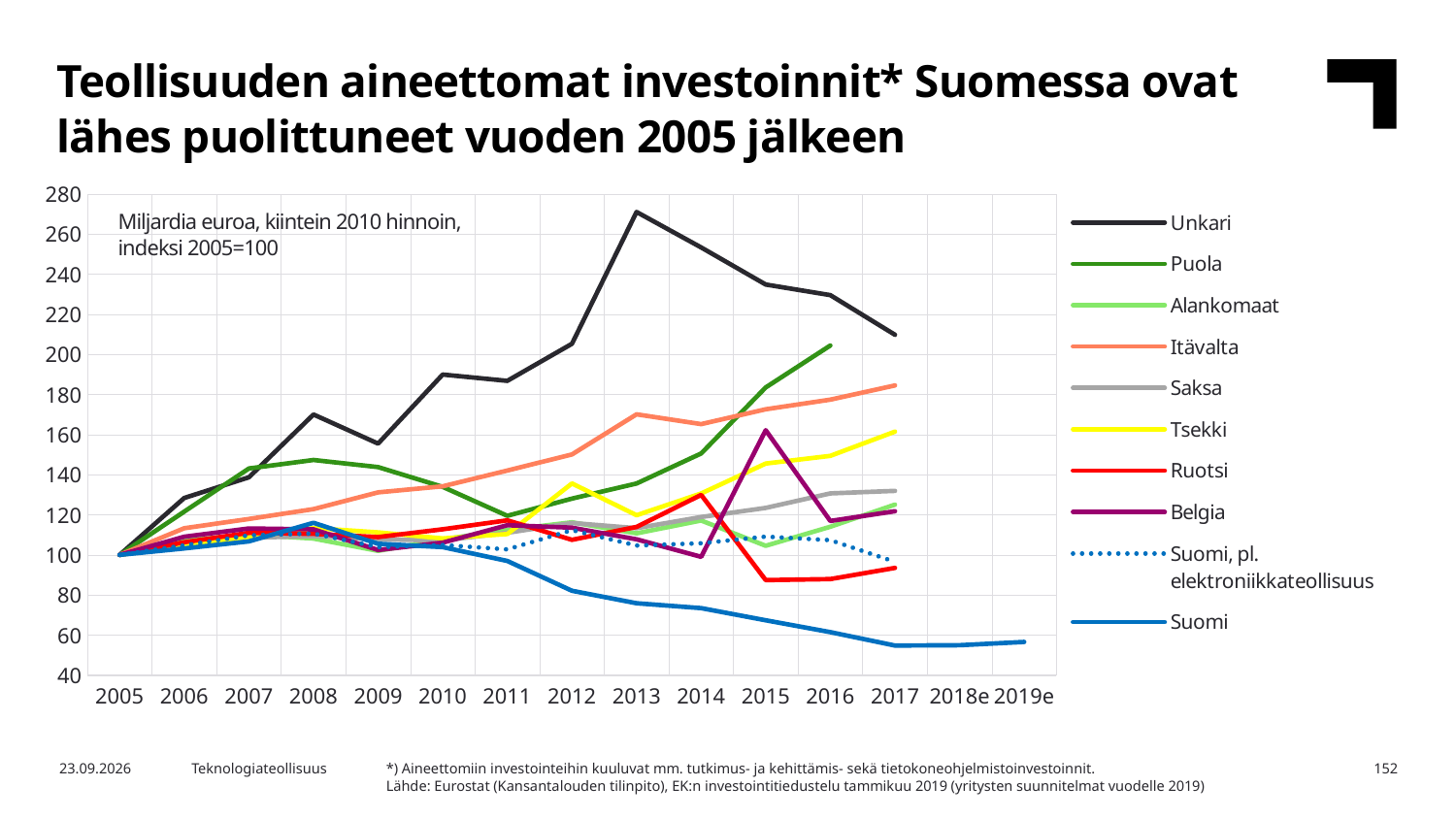
How many series does the legend list? 10 How many years are shown on the x axis? 15 Does the Suomi line rise or fall from 2008 to 2017? fall Which country has the highest value in 2013? Unkari Which series has the lowest value in 2017? Suomi Which is larger in 2017, the value for Unkari or the value for Suomi? Unkari What kind of chart is shown on the slide? line chart Is the value for Unkari in 2013 greater or less than 260? greater Is the value for Ruotsi in 2015 greater or less than 100? less Is the value for Suomi in 2017 greater or less than 60? less Which series is drawn with a dotted line? Suomi, pl. elektroniikkateollisuus What is the index value for Suomi in 2005? 100